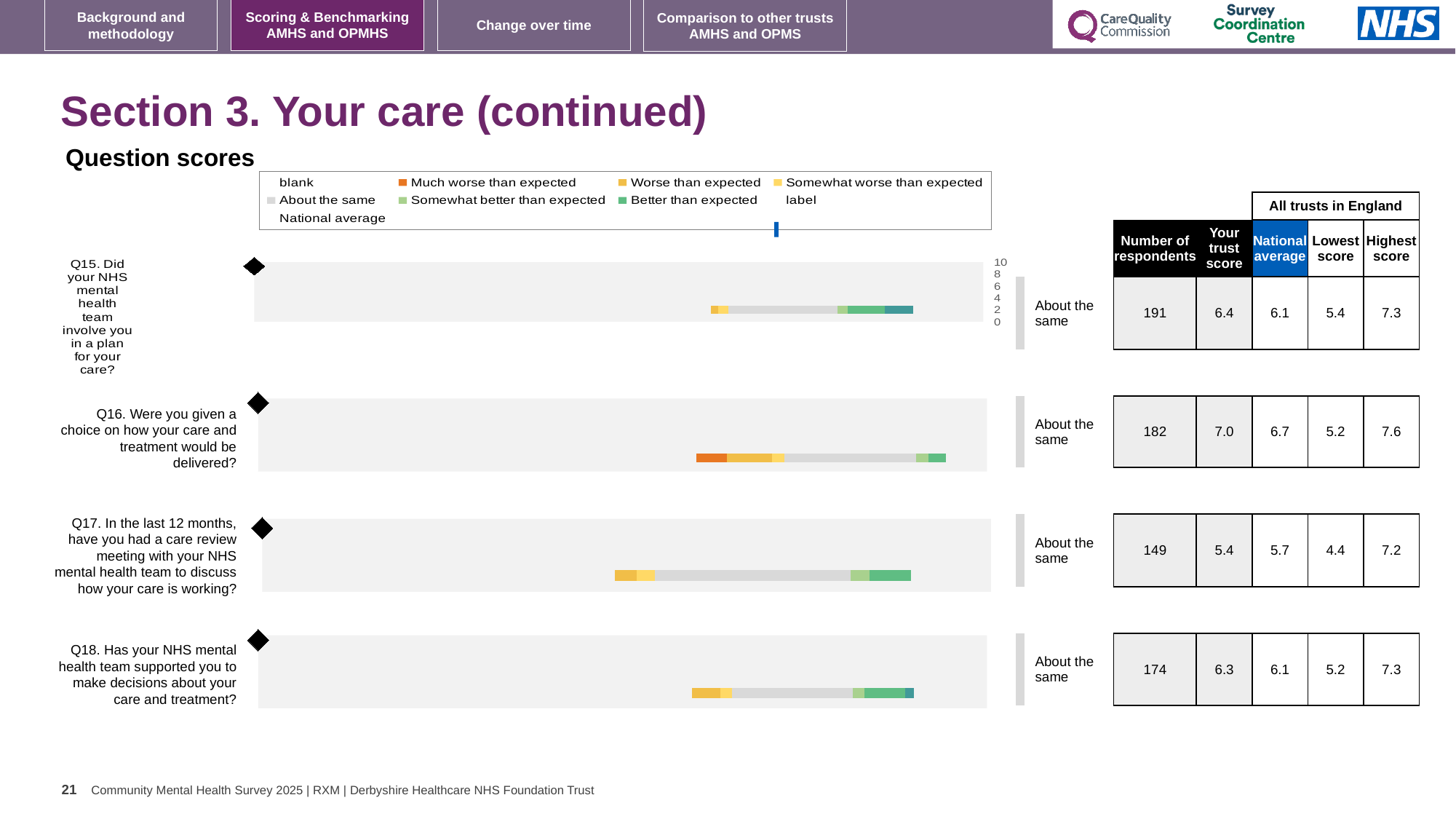
Which question has the highest 'Your trust score'? Q16 What is the 'Your trust score' value for Q16 (Were you given a choice on how your care and treatment would be delivered?)? 7.0 What benchmark label is shown next to the Q18 chart? About the same Which question has the lowest 'Your trust score'? Q17 How many respondents answered Q15 (Did your NHS mental health team involve you in a plan for your care?)? 191 What is the Highest score across all trusts in England for Q18 (supported you to make decisions about your care and treatment)? 7.3 For Q17, which is larger: the trust score or the National average? National average What is the National average for Q17 (care review meeting in the last 12 months)? 5.7 How many entries does the legend above the charts list? 9 What kind of chart is used to show the question scores for Q15 to Q18? Bar chart How many question charts (Q15 to Q18) are shown on the slide? 4 For Q16, what is the difference between the Highest score and the Lowest score across all trusts in England? 2.4